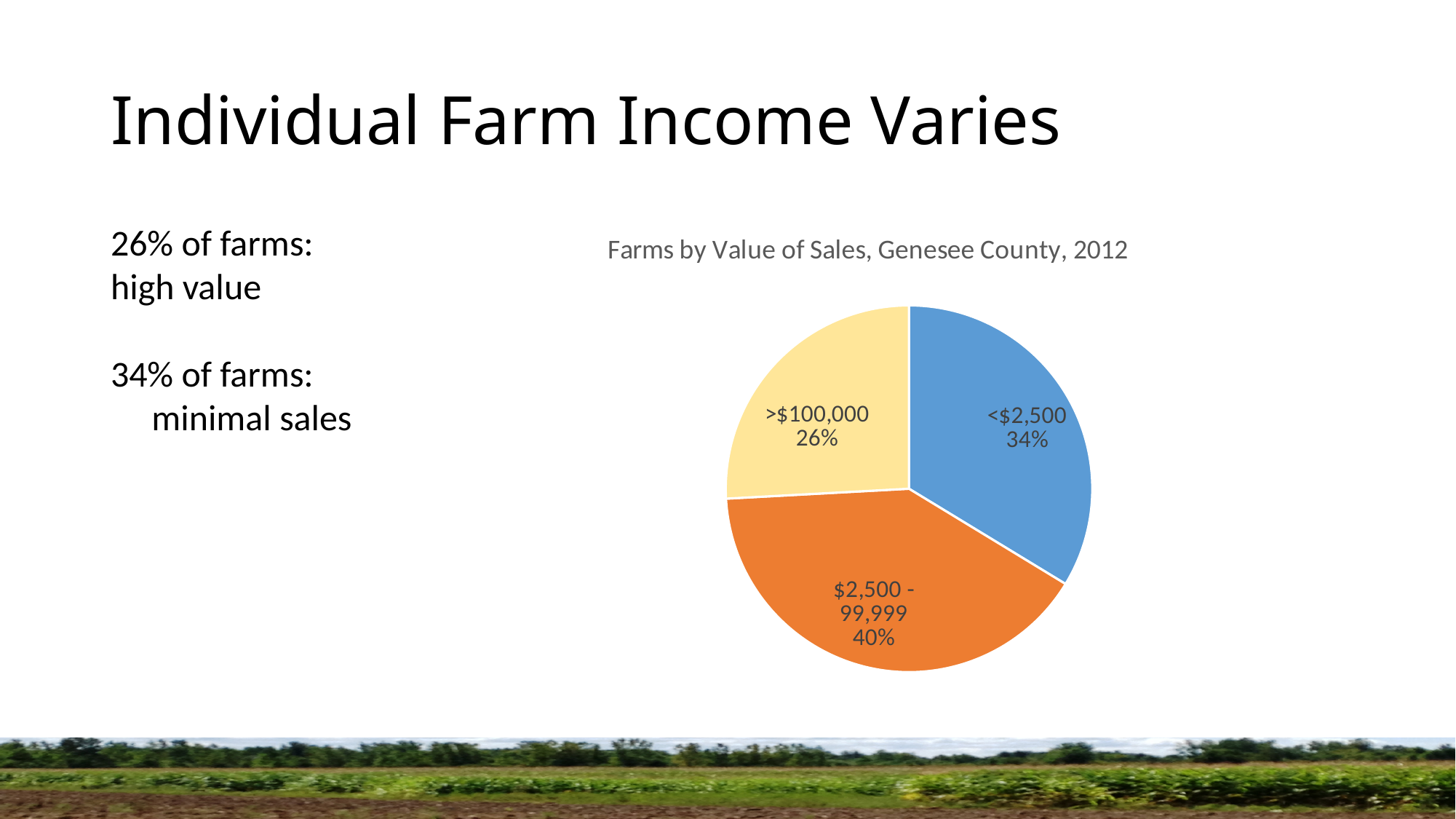
What share of farms had sales of $2,500 - 99,999? 40% What share of farms had sales of less than $2,500? 34% Which sales category has the largest share of farms? $2,500 - 99,999 What is the difference in percentage points between the $2,500 - 99,999 slice and the >$100,000 slice? 14 How many slices does the pie chart have? 3 What share of farms had sales of more than $100,000? 26% What kind of chart is shown on the slide? pie chart Which is larger, the share of farms with sales <$2,500 or the share with sales >$100,000? <$2,500 What colour is the slice for farms with sales >$100,000? yellow What is the title of the chart? Farms by Value of Sales, Genesee County, 2012 Which sales category has the smallest share of farms? >$100,000 What is the difference in percentage points between the <$2,500 slice and the >$100,000 slice? 8